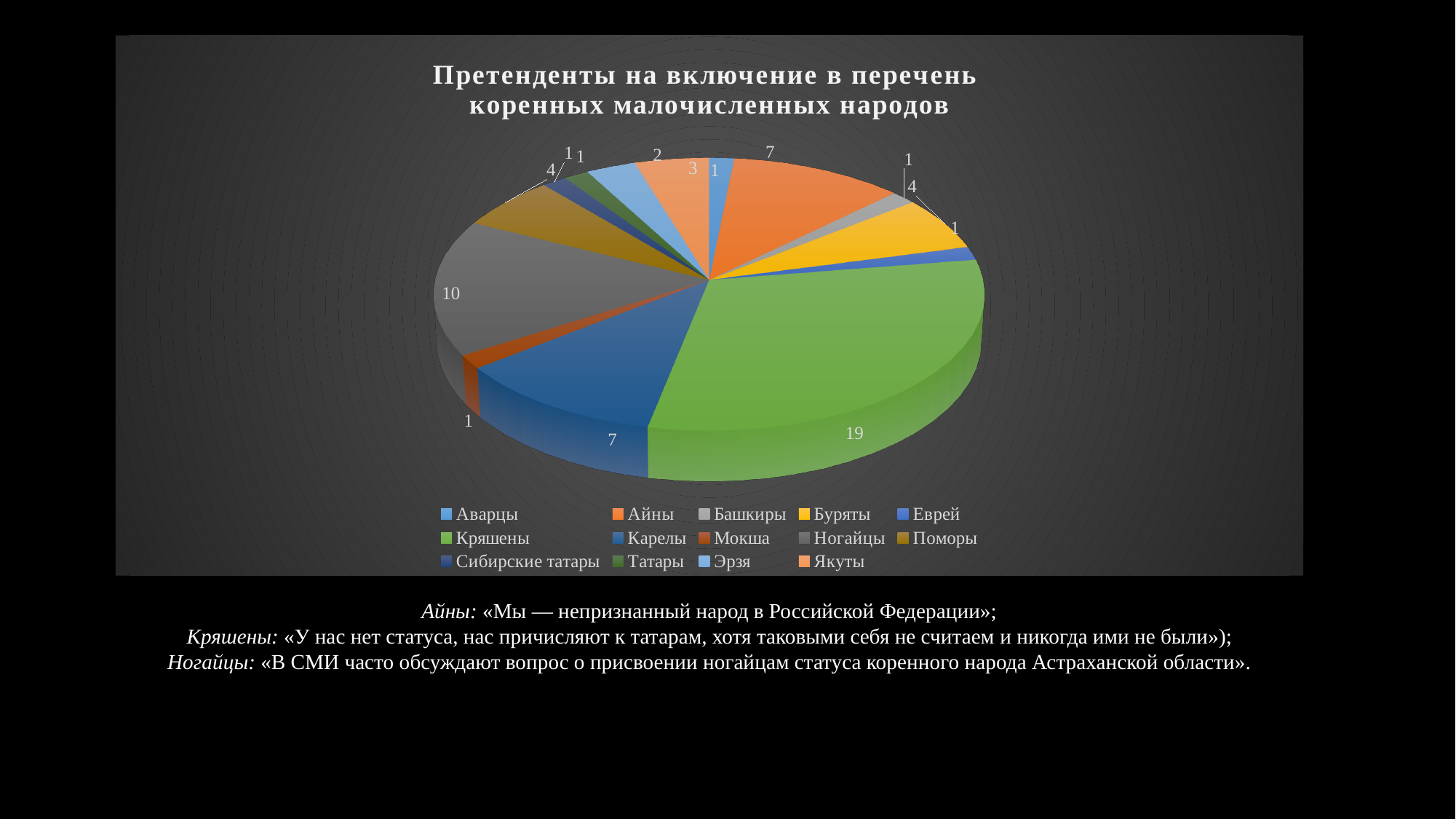
How many categories does the pie chart have? 14 What is the difference between the values for Карелы and Эрзя? 5 What is the value for Кряшены? 19 What type of chart is shown on the slide? pie chart What is the title of the chart? Претенденты на включение в перечень коренных малочисленных народов Which is larger, the value for Ногайцы or the value for Карелы? Ногайцы Which category has the largest slice of the pie? Кряшены What is the value for Ногайцы? 10 Which is larger, the value for Айны or the value for Буряты? Айны What is the value for Поморы? 4 What is the value for Якуты? 3 What is the difference between the values for Кряшены and Ногайцы? 9